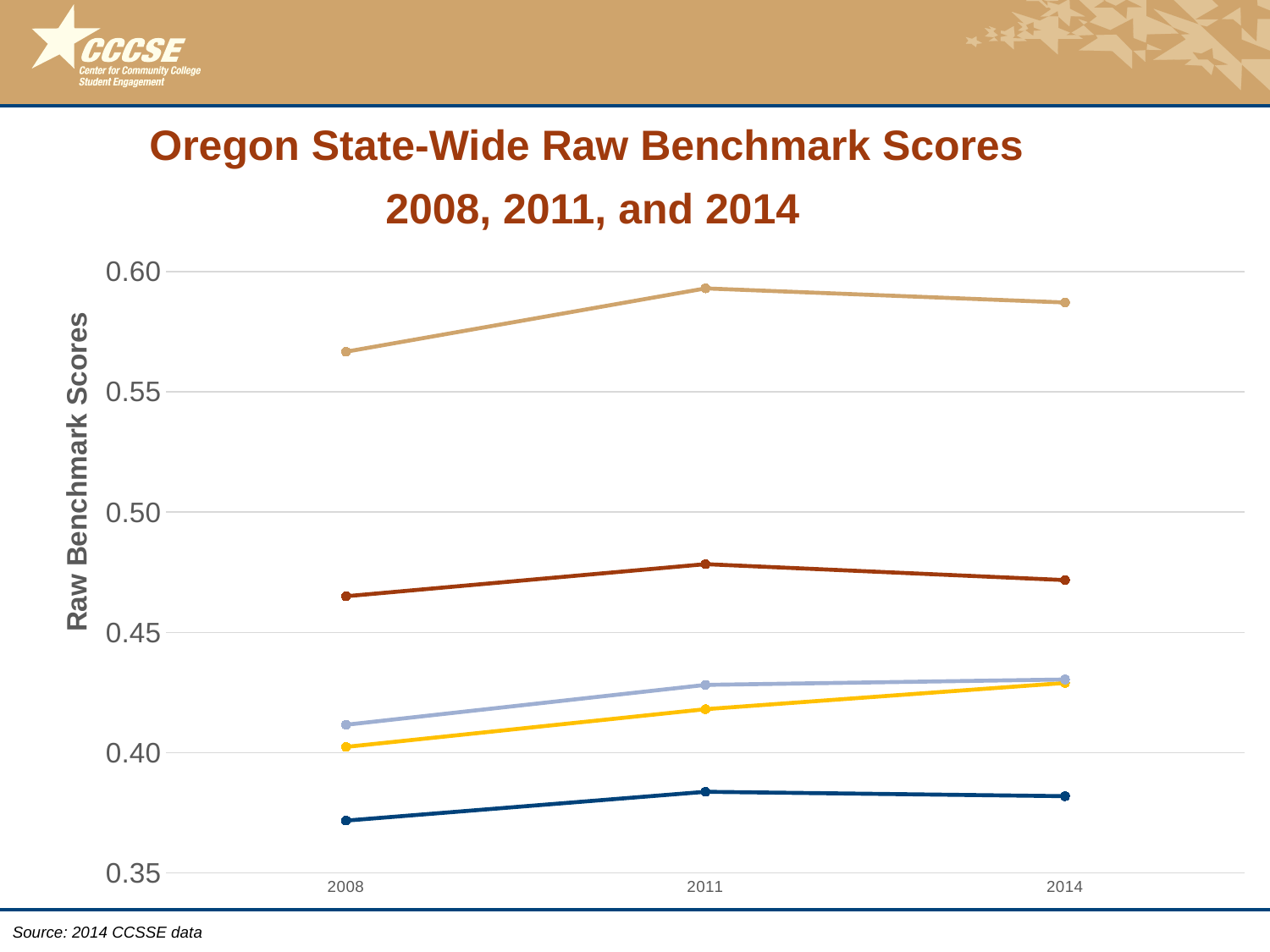
Is the value of the topmost (tan) line in 2011 greater or less than 0.55? greater What is the label on the vertical axis of the chart? Raw Benchmark Scores What is the title of the chart on the slide? Oregon State-Wide Raw Benchmark Scores 2008, 2011, and 2014 Which year has the lowest value for the lowest (dark blue) line? 2008 Does the yellow line rise or fall from 2008 to 2014? rise Is the value of the yellow line in 2014 greater or less than 0.40? greater How many years are shown along the x axis of the chart? 3 What kind of chart is shown on the slide? line chart Is the value of the dark red line in 2014 greater or less than 0.50? less Which year has the highest value for the topmost (tan) line? 2011 How many lines are plotted on the chart? 5